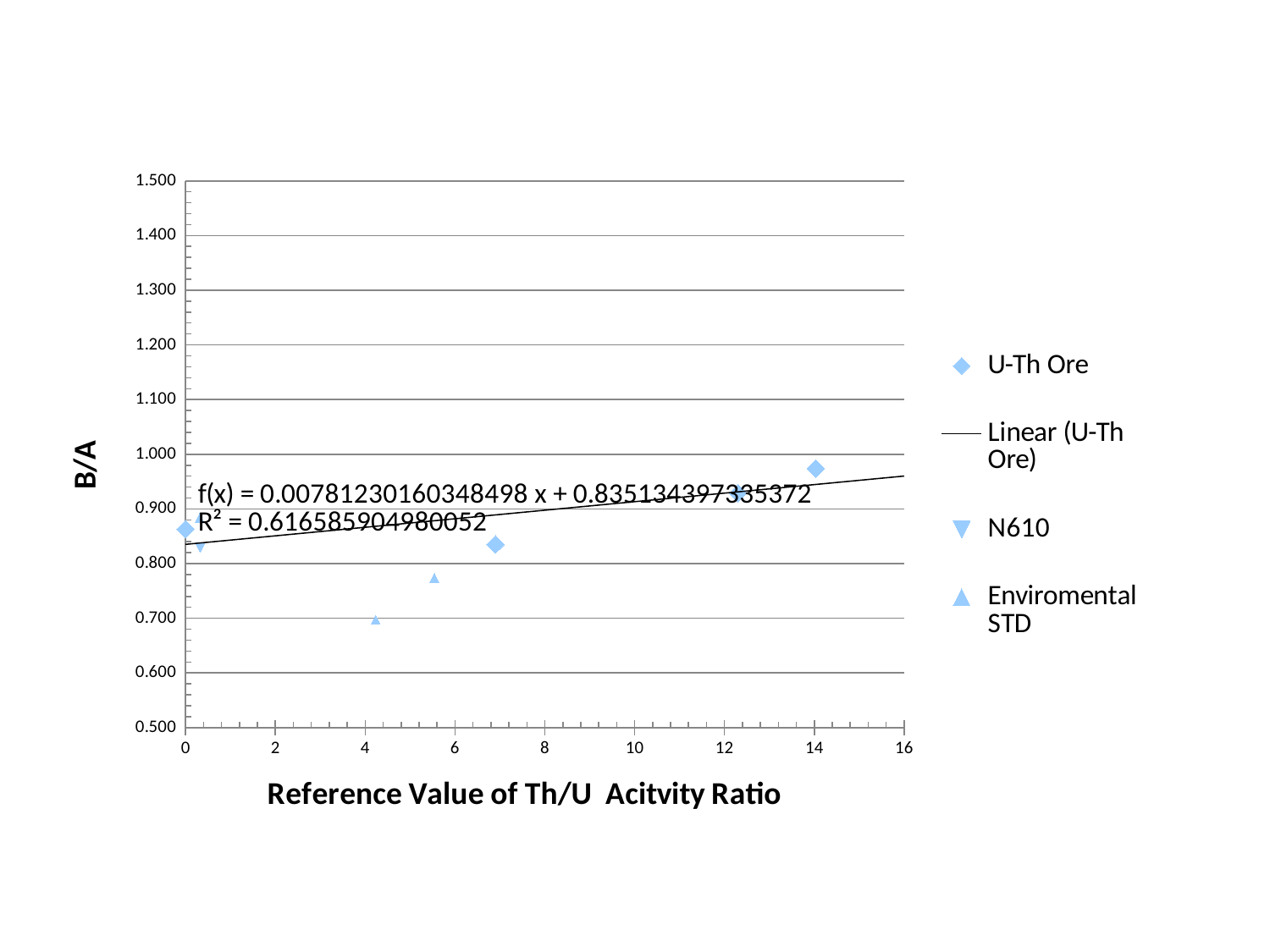
Which U-Th Ore point has the highest B/A value: the one at x = 14 or the one near x = 7? the one at x = 14 Which series has the lowest plotted B/A value on the chart? Enviromental STD How many entries does the legend list? 4 What kind of chart is shown on the slide? scatter chart Does the Linear (U-Th Ore) trendline rise or fall as the x value increases? rise How many U-Th Ore data points are plotted? 4 What is the title of the y axis? B/A Is the B/A value of the Enviromental STD point near x = 4 greater or less than 0.800? less What R² value is printed on the chart? R² = 0.616585904980052 Is the B/A value of the U-Th Ore point at x = 14 greater or less than 0.900? greater What is the title of the x axis? Reference Value of Th/U Acitvity Ratio